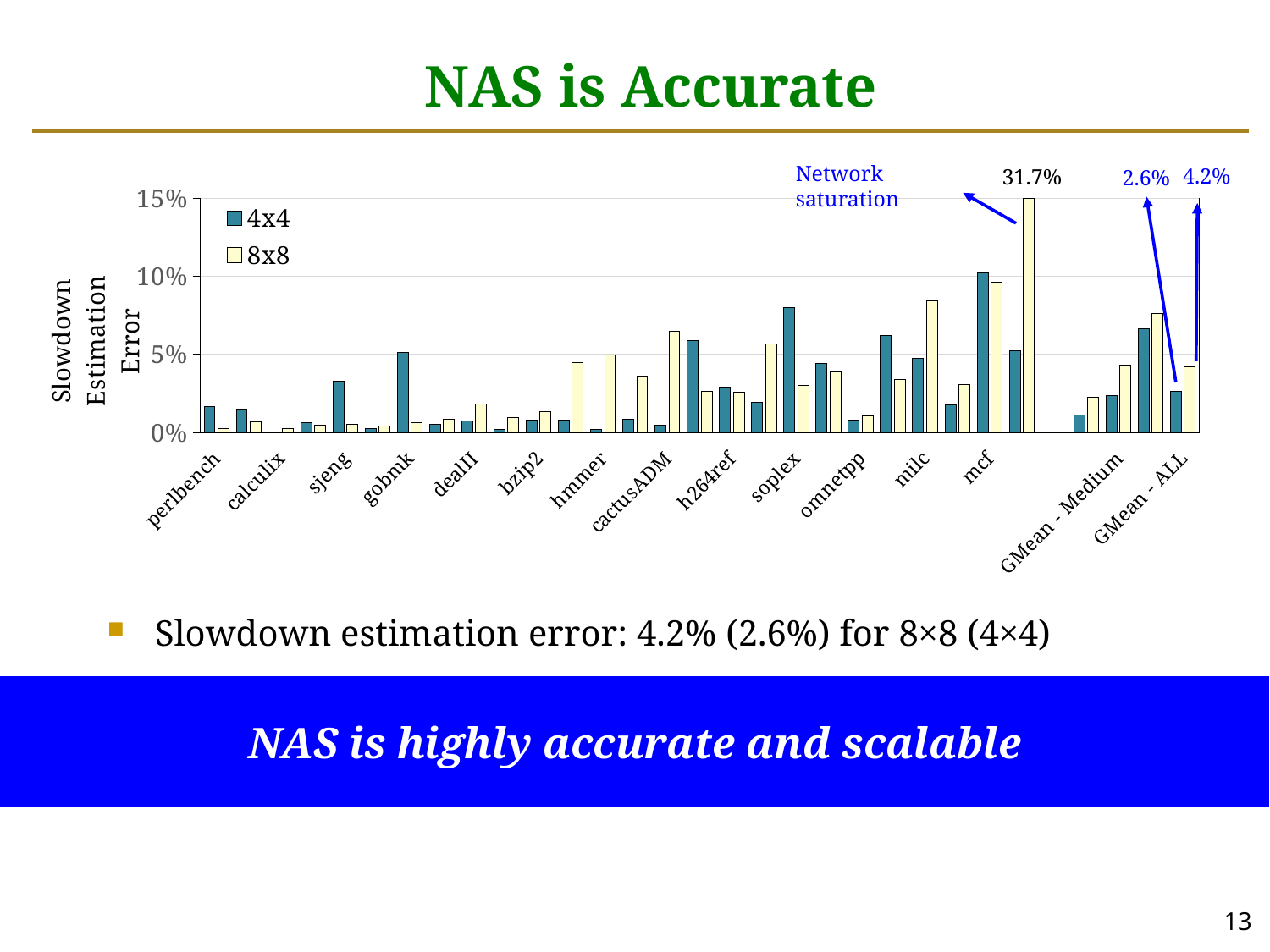
At GMean - ALL, which series has the larger value, 4x4 or 8x8? 8x8 What is the slowdown estimation error for the 4x4 series at GMean - ALL? 2.6% What is the slowdown estimation error for the 8x8 series at GMean - ALL? 4.2% What is the value of the tallest bar in the chart, labelled near the 'Network saturation' annotation? 31.7% What is the difference between the 8x8 and 4x4 values at GMean - ALL? 1.6% Is the value of the tallest bar greater or less than 15%? greater What kind of chart is shown on the slide? bar chart How many series does the legend list? 2 What is the label on the vertical axis of the chart? Slowdown Estimation Error Which series does the tallest bar (31.7%) belong to? 8x8 What are the two series named in the legend? 4x4 and 8x8